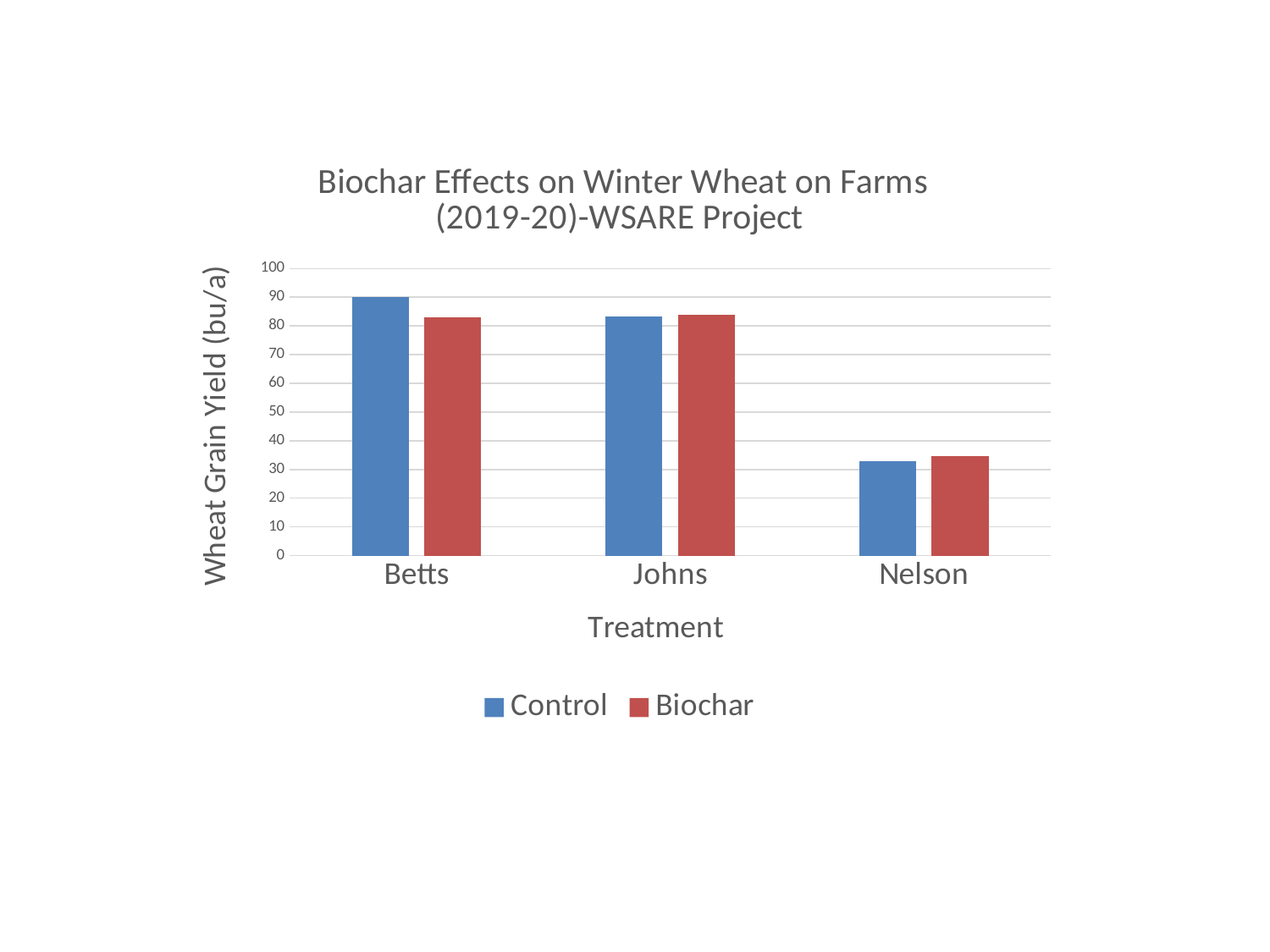
Is the Biochar value for Johns greater or less than 70? greater At Betts, which is larger, the Control yield or the Biochar yield? Control Which farm has the highest Control yield? Betts What is the label on the y axis? Wheat Grain Yield (bu/a) Which farm has the lowest Control yield? Nelson Is the Control value for Nelson greater or less than 40? less Is the Control value for Betts greater or less than 80? greater What kind of chart is shown on the slide? bar chart How many farms (categories) are shown on the x axis? 3 How many series does the legend list? 2 Which colour represents the Biochar series in the legend? red Which farm has the lowest Biochar yield? Nelson